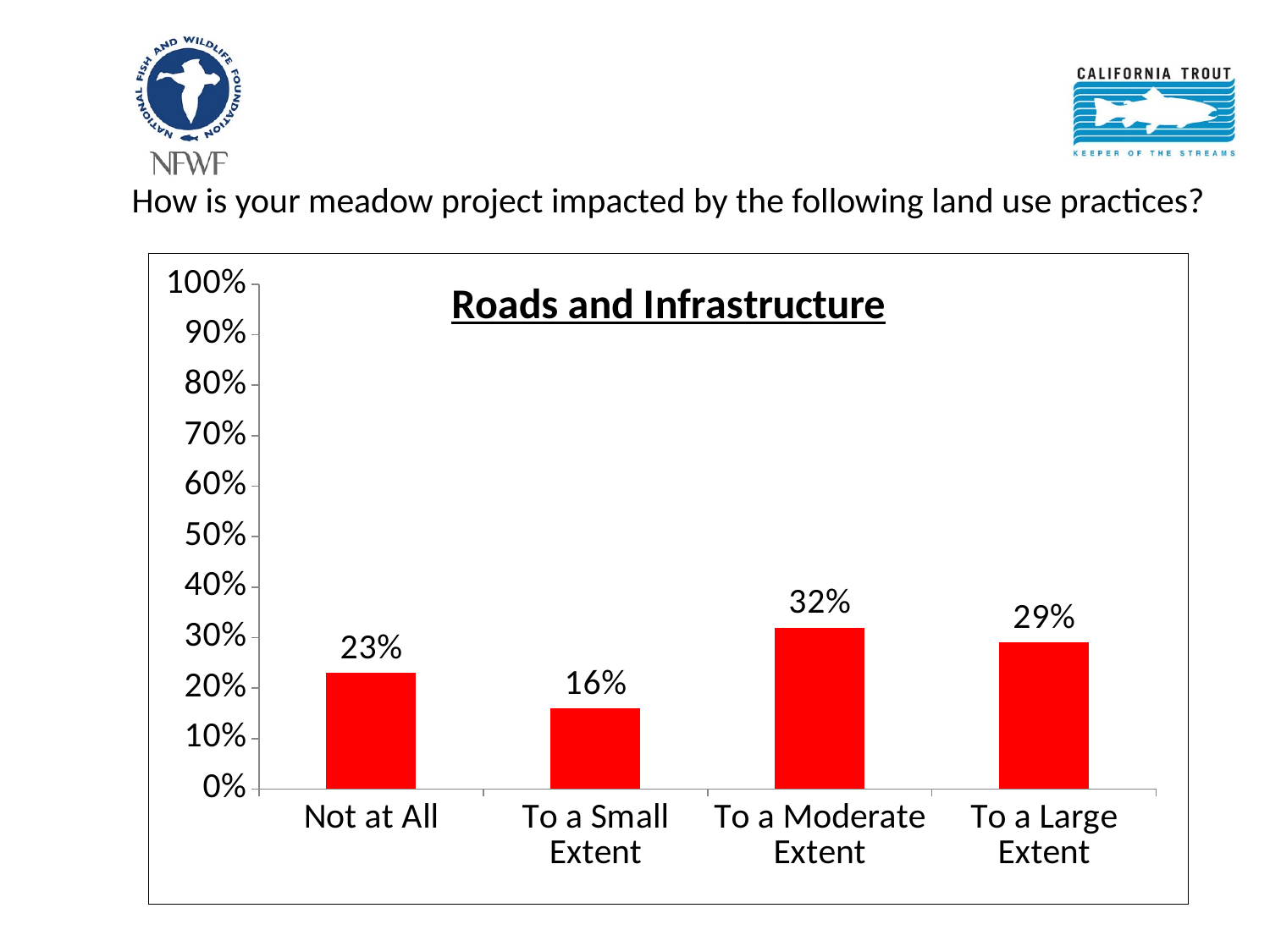
What is the value for "To a Small Extent"? 16% What is the title of the chart? Roads and Infrastructure What kind of chart is shown on the slide? bar chart What is the value for "Not at All" in the Roads and Infrastructure chart? 23% What is the value for "To a Moderate Extent"? 32% How many categories are shown on the x axis? 4 What is the difference between the values for "To a Moderate Extent" and "To a Small Extent"? 16% Is the value for "To a Moderate Extent" greater or less than 30%? greater Which category has the lowest value? To a Small Extent Which is larger, the value for "Not at All" or the value for "To a Large Extent"? To a Large Extent What is the value for "To a Large Extent"? 29% Which category has the highest value? To a Moderate Extent